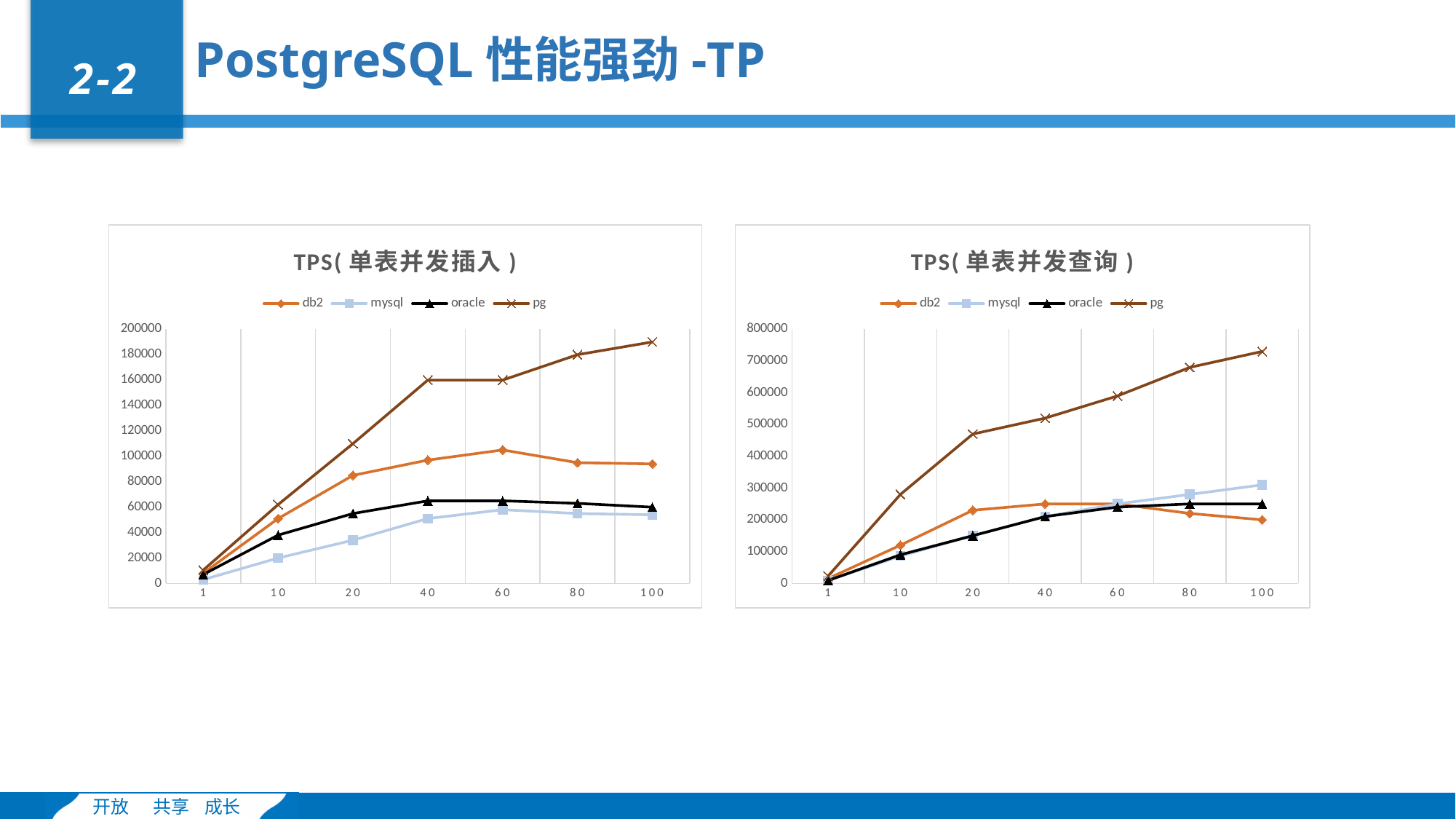
What is the title of the chart on the right side of the slide? TPS(单表并发查询) What type of chart is the TPS(单表并发插入) chart? line chart In the TPS(单表并发查询) chart, which series has the lowest value at x = 100? db2 In the TPS(单表并发查询) chart, is the value for oracle at x = 20 greater or less than 200000? less In the TPS(单表并发查询) chart, is the value for pg at x = 20 greater or less than 500000? less In the TPS(单表并发插入) chart, is the value for pg at x = 100 greater or less than 180000? greater How many series does the legend of the TPS(单表并发查询) chart list? 4 In the TPS(单表并发查询) chart, which is larger at x = 100: the value for mysql or the value for oracle? mysql How many points are plotted along the x axis for each series in the TPS(单表并发插入) chart? 7 In the TPS(单表并发插入) chart, which series has the highest value at x = 100? pg In the TPS(单表并发查询) chart, does the pg series rise or fall as the x axis goes from 1 to 100? rise